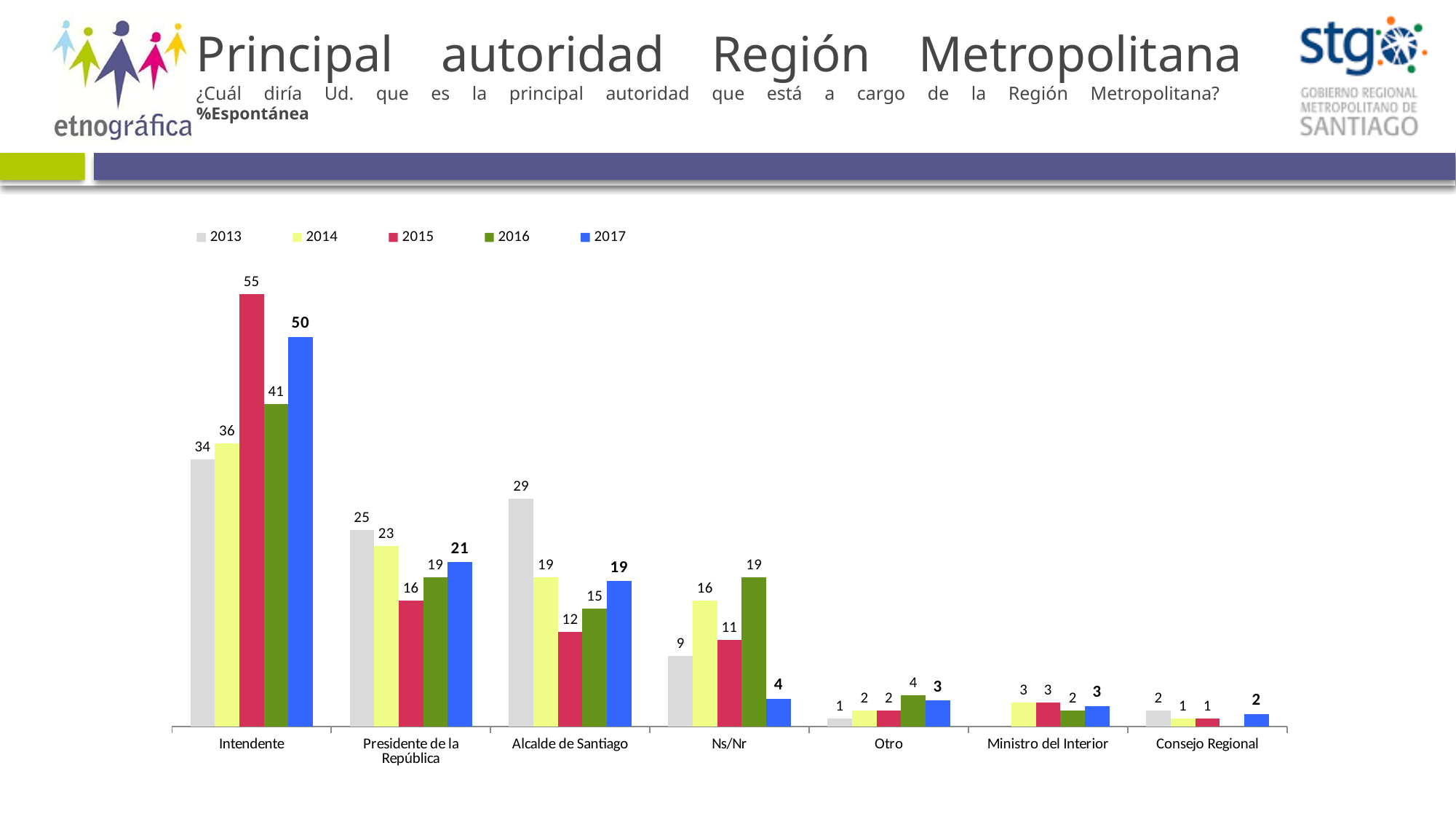
Which is larger for Ns/Nr: the 2014 value or the 2015 value? 2014 What is the value for Alcalde de Santiago in 2013? 29 What is the value for Presidente de la República in 2015? 16 Which category has the lowest value in 2017? Consejo Regional How many categories are shown on the x axis? 7 Which series is shown in blue in the legend? 2017 What is the value for Intendente in 2017? 50 What is the value for Ns/Nr in 2016? 19 What is the difference between the 2015 and 2017 values for Intendente? 5 How many series does the legend list? 5 Which year has the highest value for Intendente? 2015 What kind of chart is shown on the slide? Bar chart